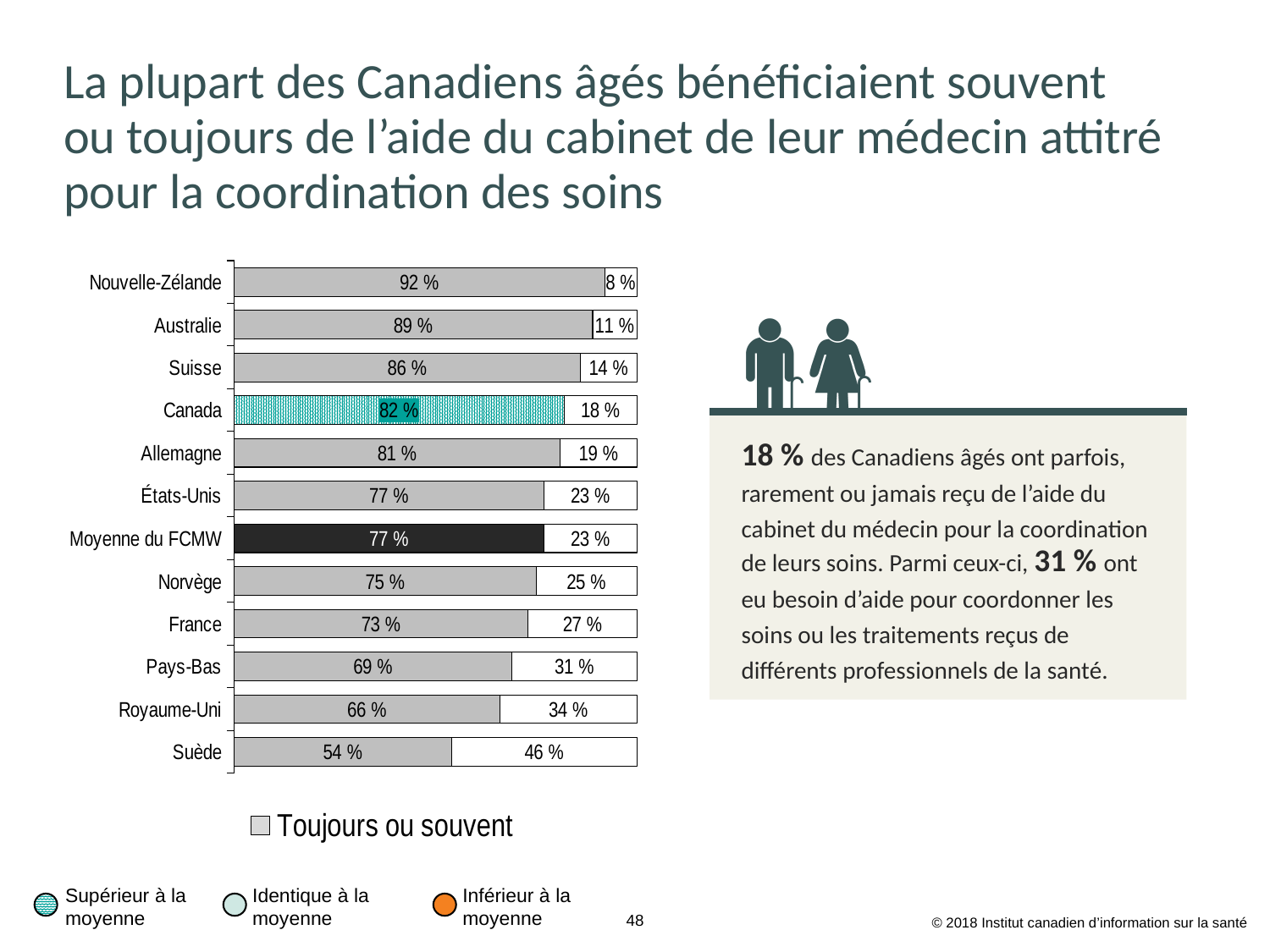
What kind of chart is shown on the slide? Stacked bar chart What is the legend entry shown below the chart? Toujours ou souvent What is the value of the white (right-hand) segment for Pays-Bas? 31 % Which category has the lowest 'Toujours ou souvent' value? Suède How many categories are shown on the chart? 12 Which has a larger 'Toujours ou souvent' value, Allemagne or France? Allemagne What is the total of the two segments of the Royaume-Uni bar? 100 % How many series does the legend list? 1 Which country has the highest 'Toujours ou souvent' value? Nouvelle-Zélande What is the 'Toujours ou souvent' value for Suède? 54 % What is the 'Toujours ou souvent' value for Canada? 82 % What is the difference between the 'Toujours ou souvent' values for Canada and Moyenne du FCMW? 5 %